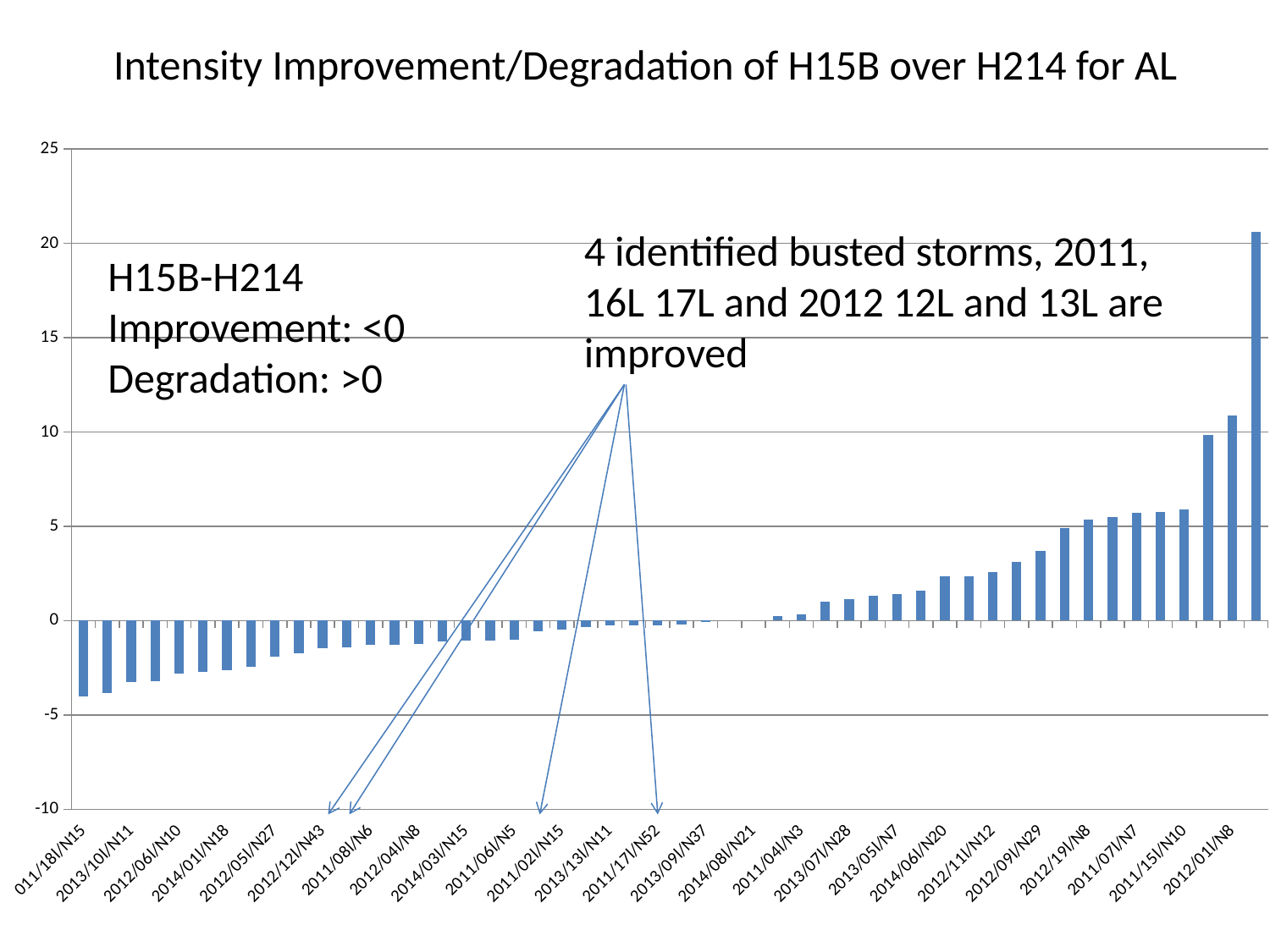
Is the value of the rightmost bar greater or less than 15? greater Is the value of the leftmost bar greater or less than -5? greater Is the value of the leftmost bar greater or less than 0? less Which bar has the highest value on the chart? the rightmost bar What is the title of the chart? Intensity Improvement/Degradation of H15B over H214 for AL What kind of chart is shown on the slide? bar chart Which bar has the lowest value on the chart? the leftmost bar Do the bar values rise or fall moving from left to right along the x axis? rise According to the text on the slide, how many identified busted storms are improved? 4 Which bar is higher, the leftmost bar or the rightmost bar? the rightmost bar